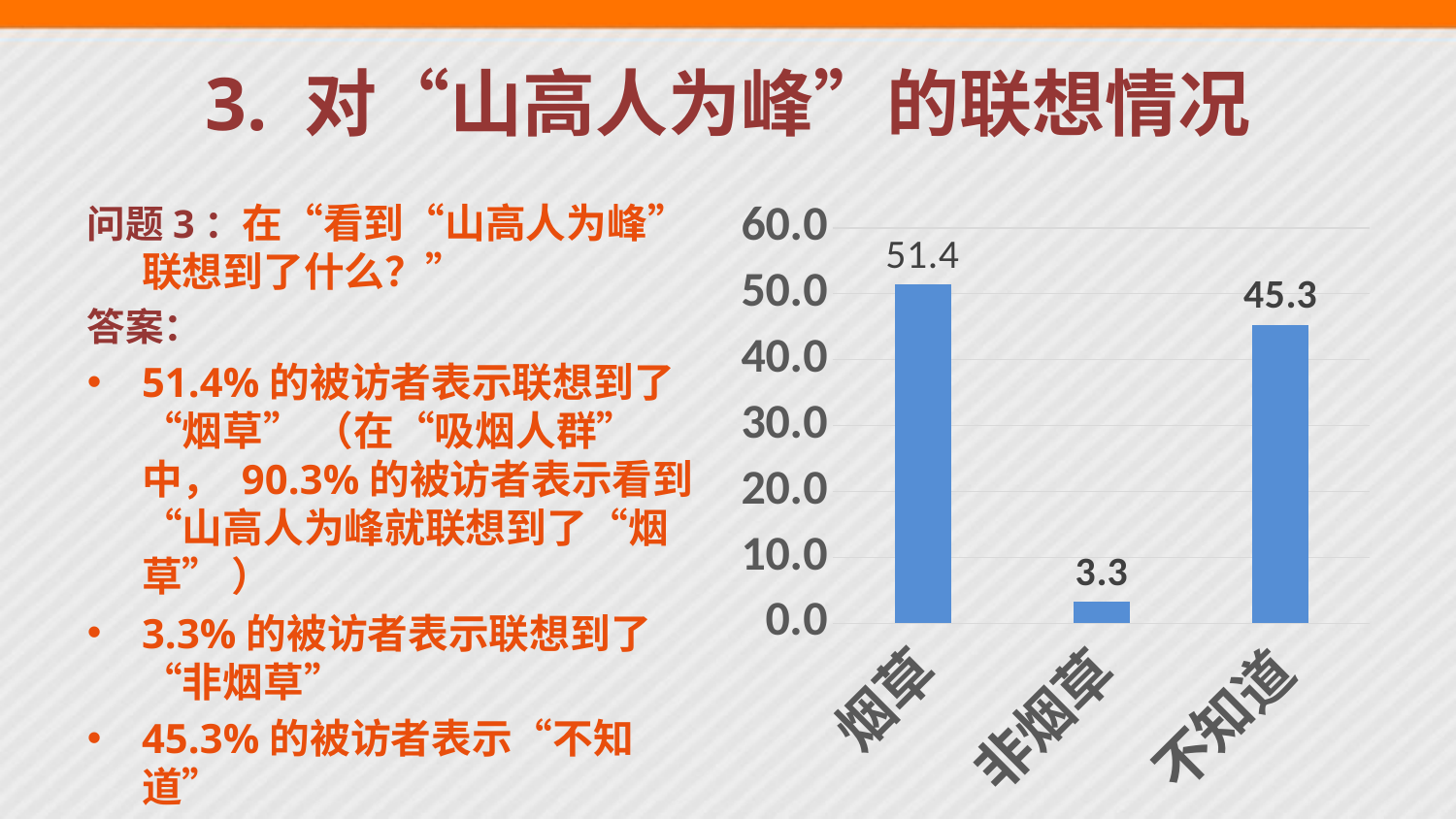
What is the difference between the values for 烟草 and 不知道? 6.1 What is the value for 烟草 in the chart? 51.4 How many categories are shown in the chart? 3 Which category has the highest value in the chart? 烟草 What is the value for 不知道 in the chart? 45.3 Which is larger, the value for 烟草 or the value for 不知道? 烟草 What is the difference between the values for 不知道 and 非烟草? 42.0 Is the value for 不知道 greater or less than 40.0? greater Which category has the lowest value in the chart? 非烟草 What is the highest value shown on the vertical axis of the chart? 60.0 What kind of chart is shown on the slide? bar chart What is the value for 非烟草 in the chart? 3.3